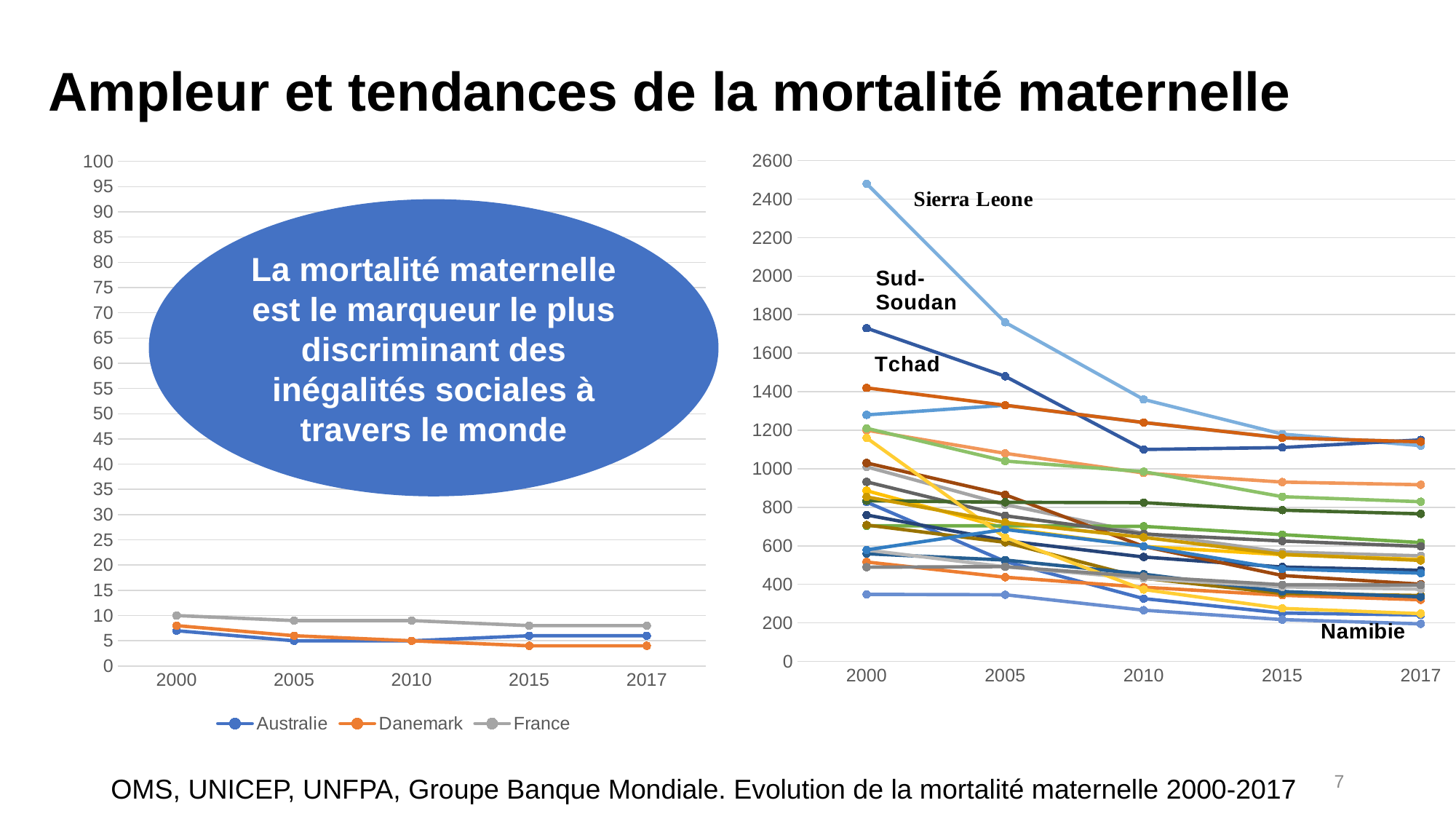
In the right chart, does the Sierra Leone line rise or fall from 2000 to 2017? fall In the right chart, which country has the highest value in 2000? Sierra Leone In the left chart, is the value for France in 2000 greater or less than 15? less In the right chart, is the value for Namibie in 2017 greater or less than 400? less How many series does the legend of the left chart list? 3 In the right chart, is the value for Sierra Leone in 2000 greater or less than 2400? greater Which series are listed in the legend of the left chart? Australie, Danemark, France What kind of chart is the left chart with the Australie, Danemark and France series? line chart In the left chart, which series has the highest value in 2000? France In the left chart, which is larger in 2017, France or Danemark? France How many years are shown on the x axis of the left chart? 5